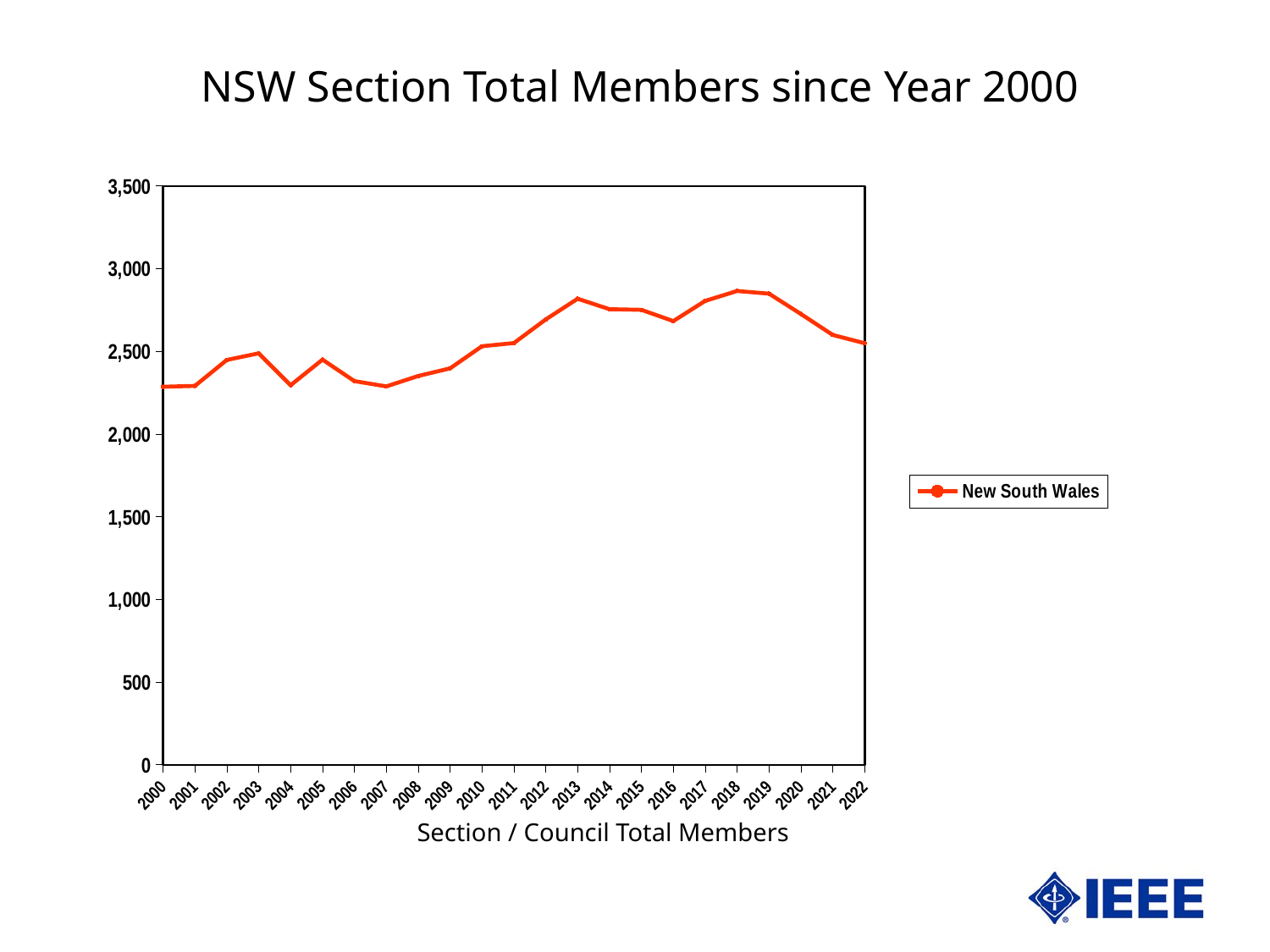
How many series does the legend list? 1 Which year has the larger value, 2013 or 2000? 2013 Is the value for 2018 greater or less than 3,000? less What kind of chart is shown on the slide? line chart What is the name of the series shown in the legend? New South Wales Is the value for 2004 greater or less than 2,500? less Is the value for 2013 greater or less than 2,500? greater How many years are plotted along the x axis? 23 Do the values rise or fall from 2019 to 2022? fall What is the title of the chart? NSW Section Total Members since Year 2000 Which year has the larger value, 2018 or 2022? 2018